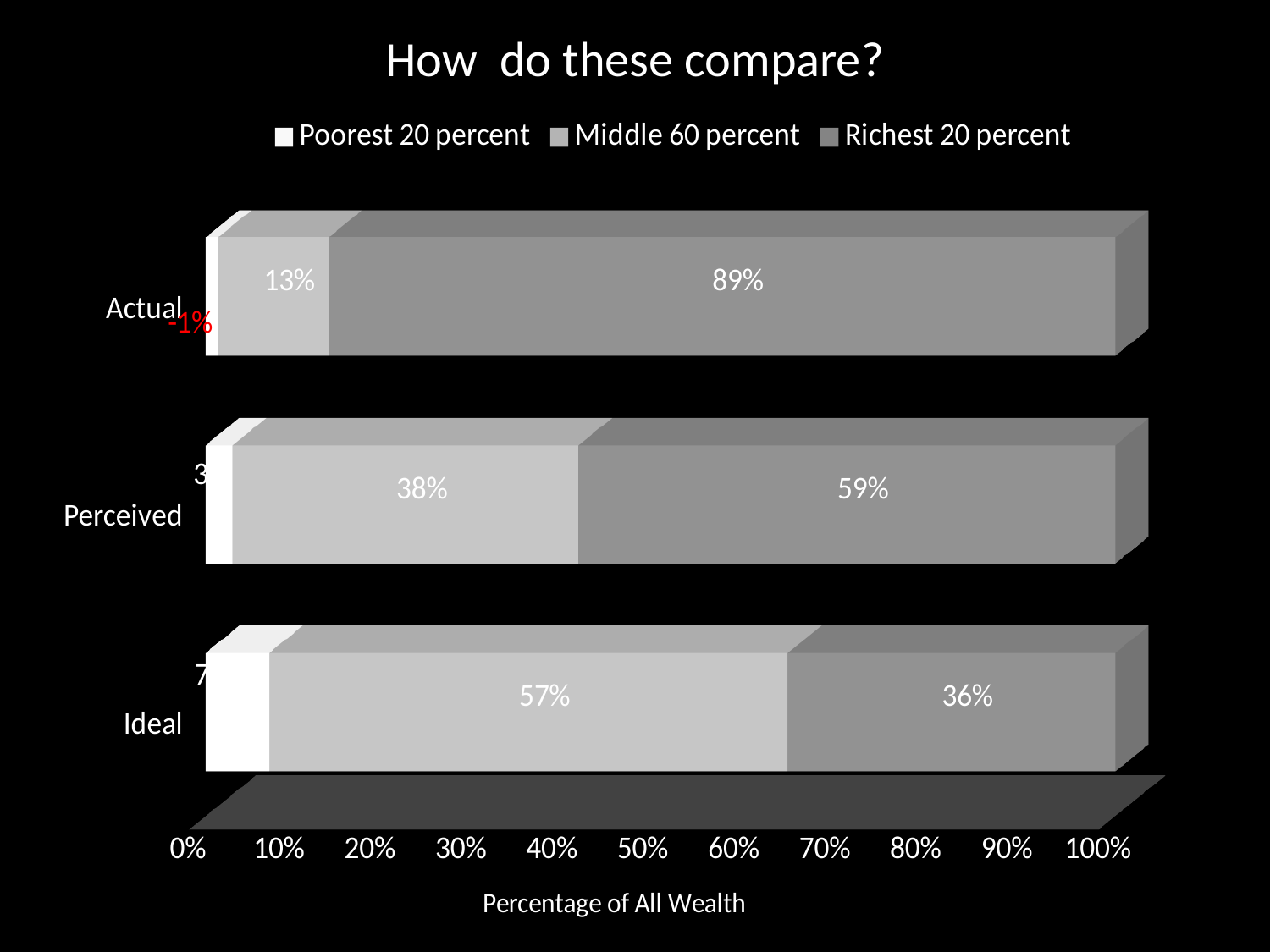
Which category has the highest value for Richest 20 percent? Actual What is the value for Poorest 20 percent in the Actual bar? -1% What is the value for Richest 20 percent in the Ideal bar? 36% What kind of chart is shown on the slide? Stacked bar chart How many series does the legend list? 3 What is the value for Middle 60 percent in the Perceived bar? 38% Which category has the lowest value for Middle 60 percent? Actual What is the value for Richest 20 percent in the Actual bar? 89% What is the difference between the Richest 20 percent values for Actual and Ideal? 53 percentage points What is the value for Middle 60 percent in the Ideal bar? 57% What is the title of the horizontal axis? Percentage of All Wealth How many categories are plotted on the chart? 3